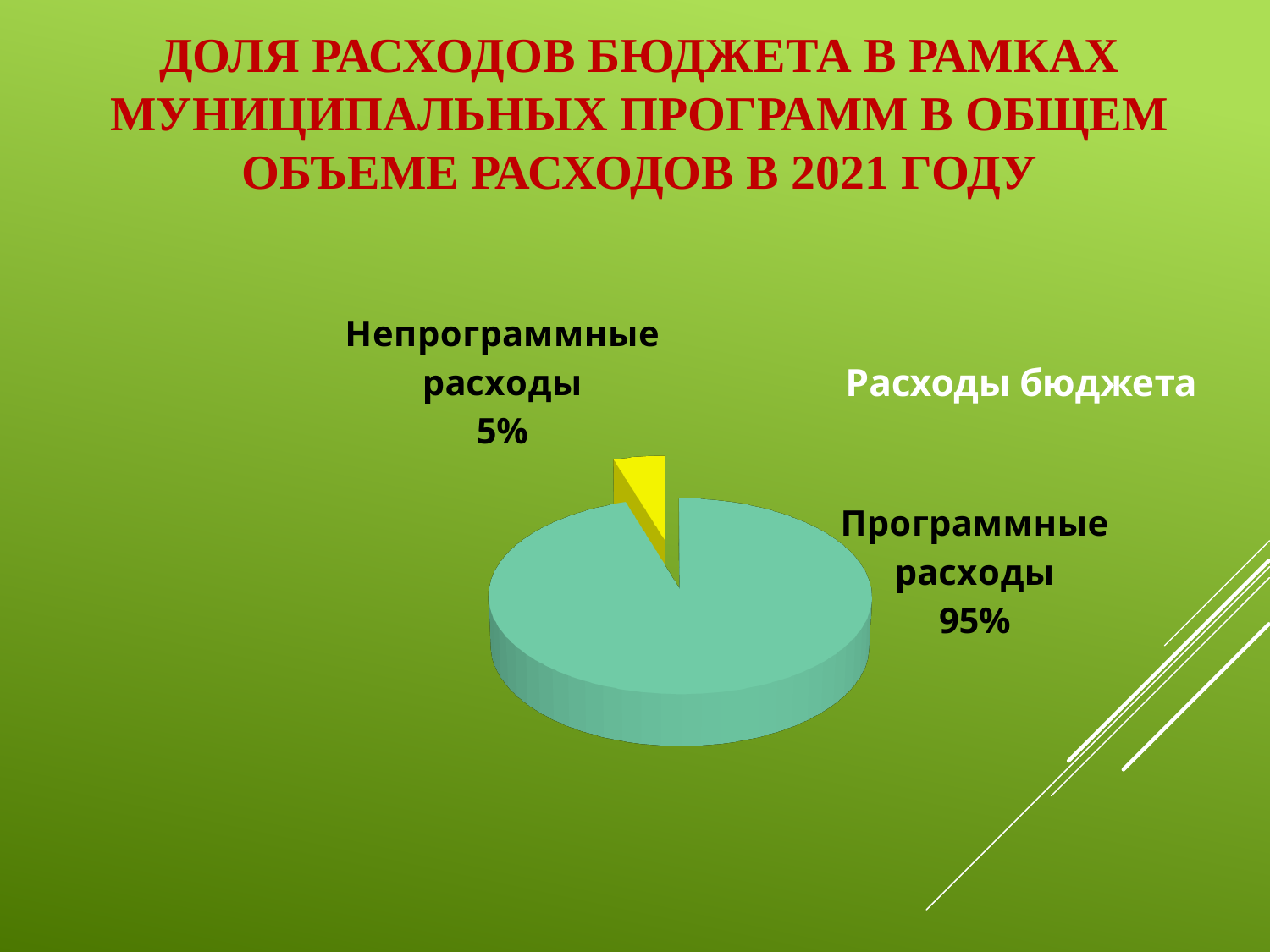
What is the share of Непрограммные расходы in the pie chart? 5% What kind of chart is shown on the slide? Pie chart Which slice of the pie chart is the smallest? Непрограммные расходы What is the total of the two slices shown in the pie chart? 100% What colour is the slice for Непрограммные расходы? Yellow What is the title of the pie chart? Расходы бюджета How many slices does the pie chart have? 2 What is the share of Программные расходы in the pie chart? 95% Which is larger, Программные расходы or Непрограммные расходы? Программные расходы Which slice of the pie chart is the largest? Программные расходы What is the difference in percentage points between Программные расходы and Непрограммные расходы? 90